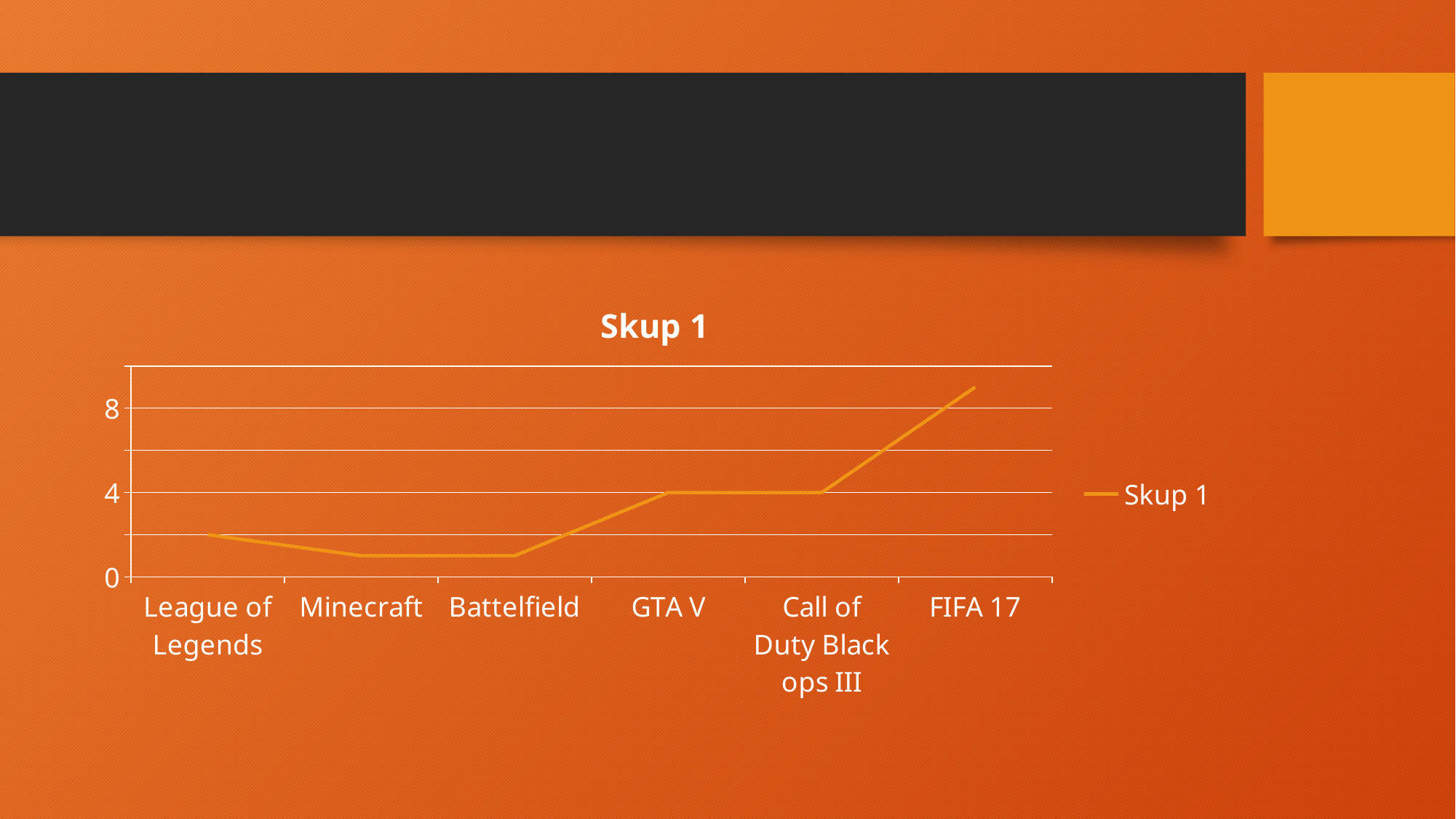
Which is larger, the value for League of Legends or the value for Minecraft? League of Legends From Battlefield to FIFA 17, do the values rise or fall along the x axis? rise Is the value for Minecraft greater or less than 4? less How many series does the legend list? 1 How many categories are plotted along the x axis? 6 What kind of chart is shown on the slide? line chart Is the value for FIFA 17 greater or less than 8? greater Which is larger, the value for FIFA 17 or the value for GTA V? FIFA 17 What is the value for GTA V? 4 Which category has the highest value? FIFA 17 What is the title of the chart? Skup 1 What is the value for Call of Duty Black ops III? 4